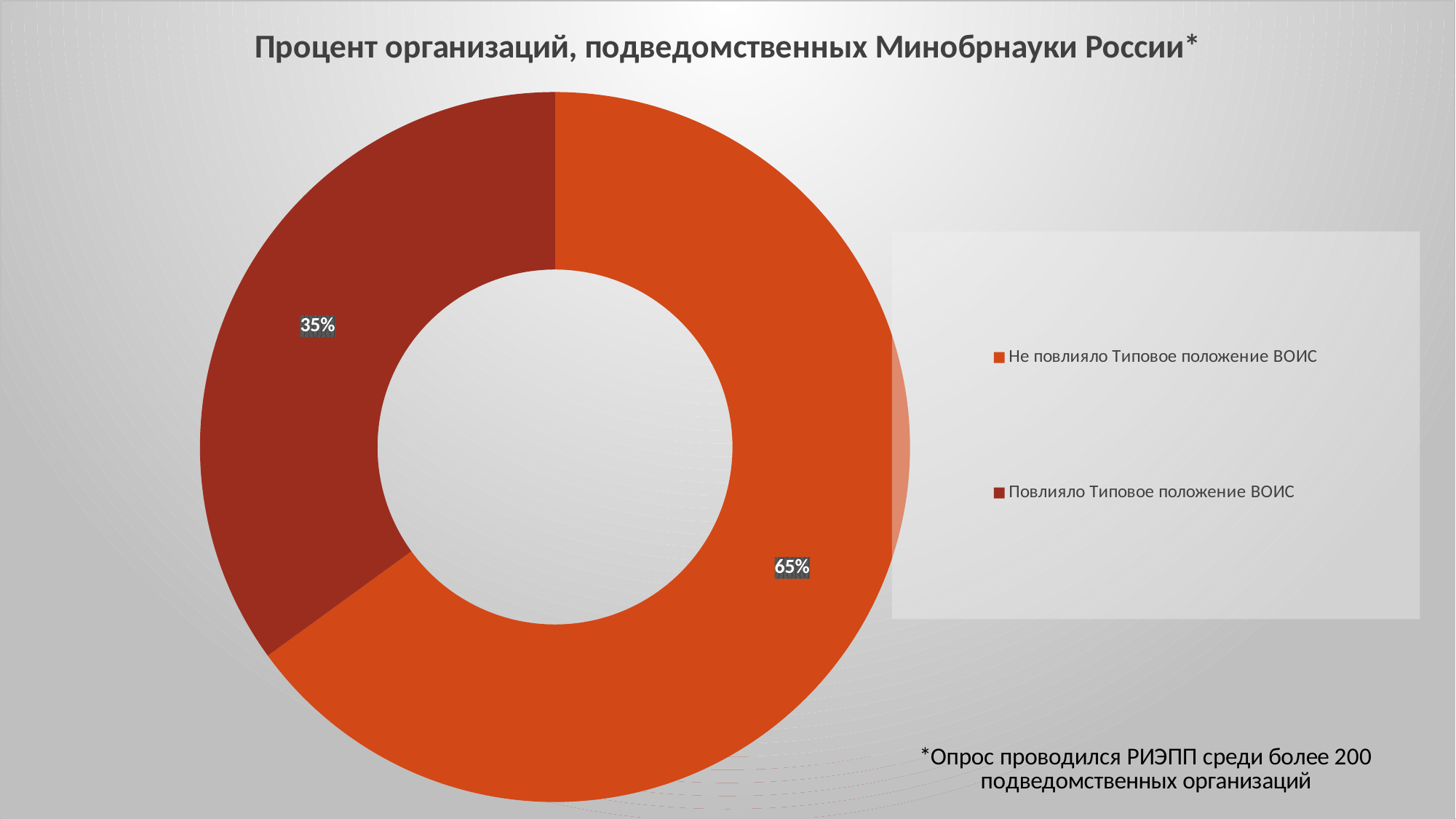
Which category has the smallest share of the chart? Повлияло Типовое положение ВОИС What percentage of organisations is shown for "Не повлияло Типовое положение ВОИС"? 65% What kind of chart is shown on the slide? Doughnut (pie) chart What percentage of organisations is shown for "Повлияло Типовое положение ВОИС"? 35% Which category has the largest share of the chart? Не повлияло Типовое положение ВОИС Which colour represents "Повлияло Типовое положение ВОИС" in the chart? Dark red How many categories does the chart show? 2 What is the difference in percentage points between the two slices? 30 What is the total of the two percentages shown on the chart? 100% What is the title of the chart? Процент организаций, подведомственных Минобрнауки России* How many entries does the legend list? 2 Which is larger: the share for "Повлияло Типовое положение ВОИС" or for "Не повлияло Типовое положение ВОИС"? Не повлияло Типовое положение ВОИС